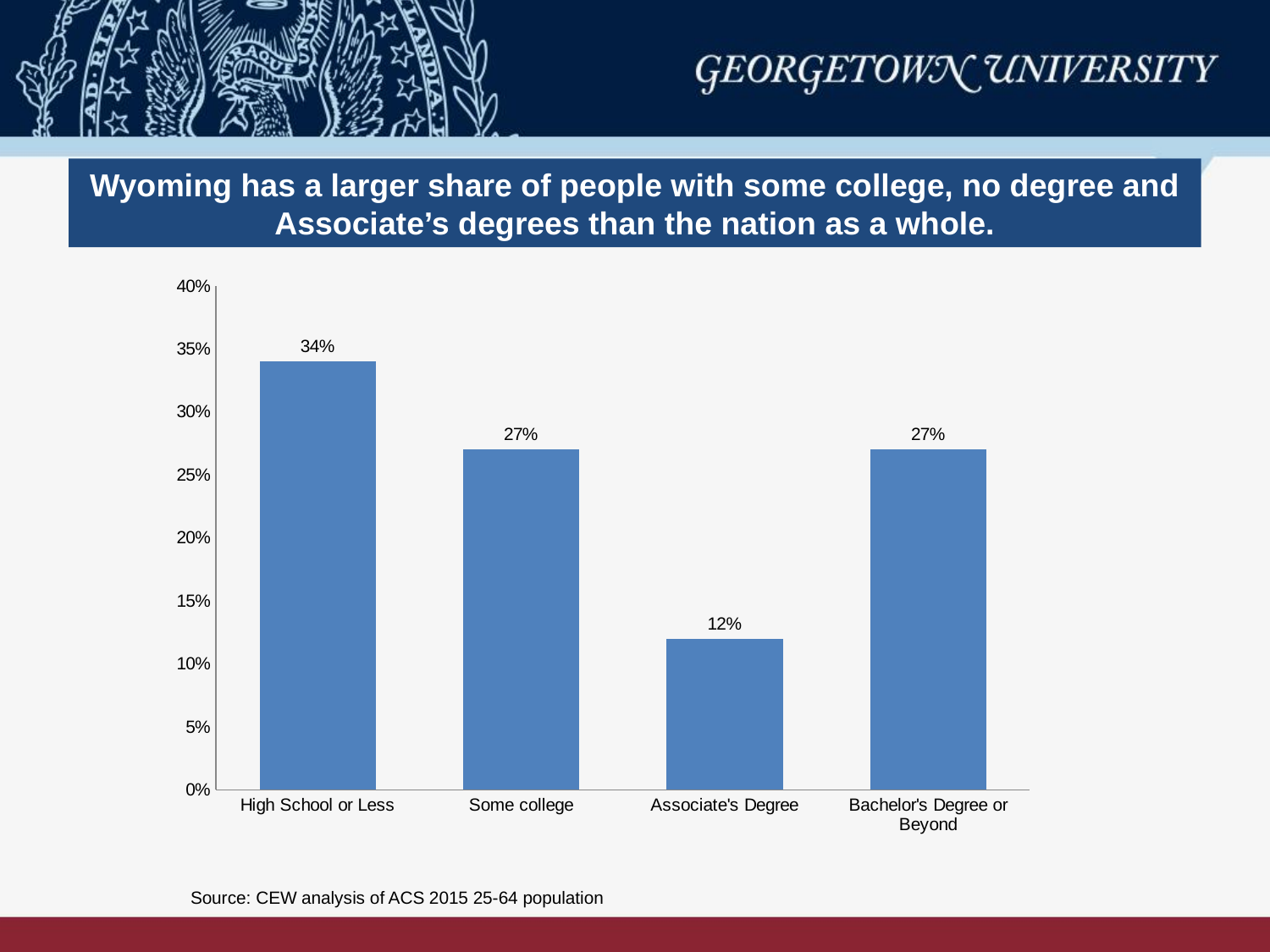
Which is larger, the value for Some college or the value for Associate's Degree? Some college Which category has the lowest value? Associate's Degree Which category has the highest value? High School or Less What is the difference between the values for High School or Less and Associate's Degree? 22% What is the value for High School or Less? 34% What is the value for Associate's Degree? 12% What is the difference between the values for High School or Less and Some college? 7% Is the value for High School or Less greater or less than 30%? greater What kind of chart is shown on the slide? Bar chart What is the value for Some college? 27% What is the value for Bachelor's Degree or Beyond? 27% How many categories are shown on the x axis? 4